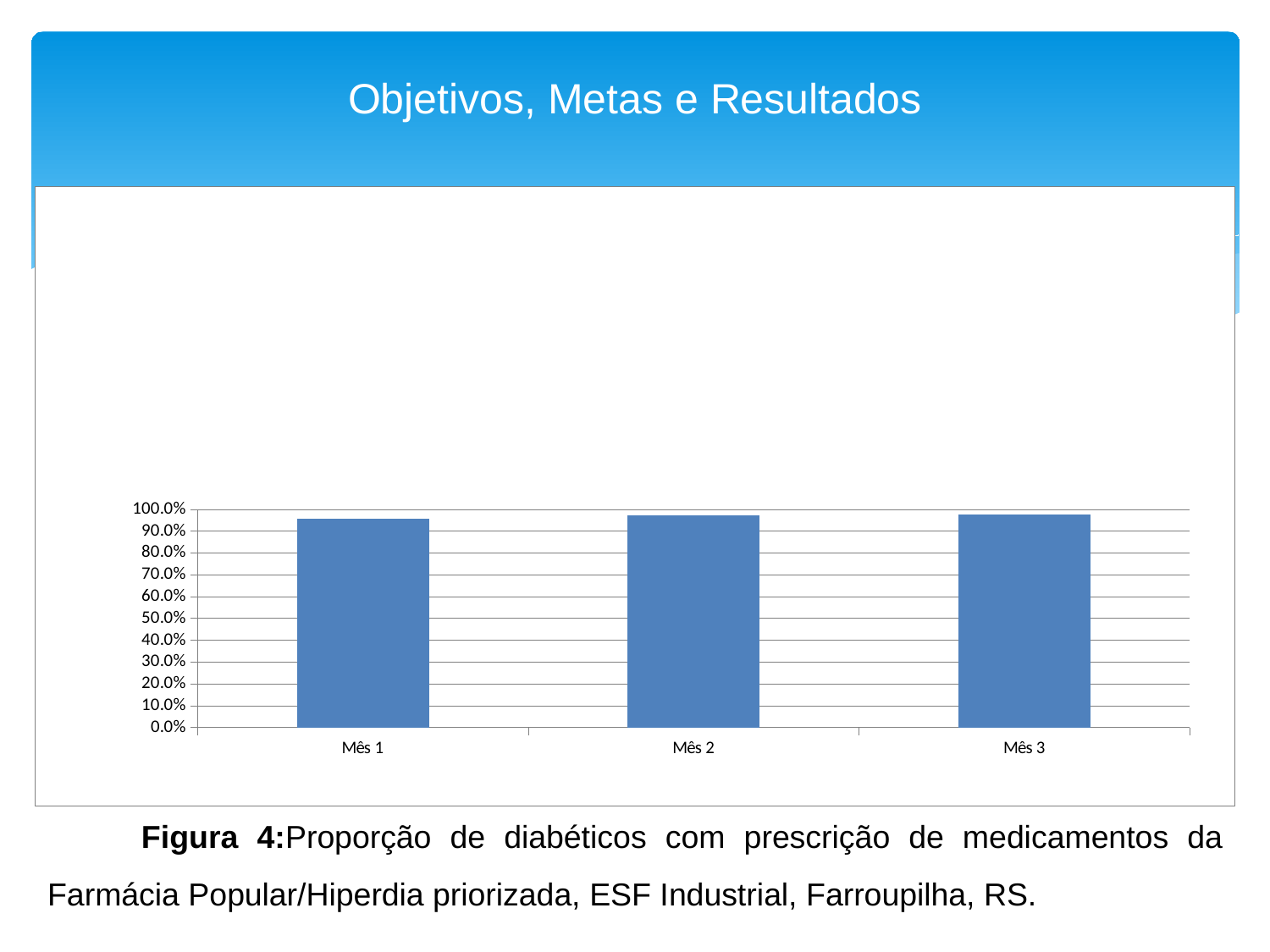
Do the bar values rise or fall from Mês 1 to Mês 3? rise What kind of chart is shown on the slide? bar chart Is the value for Mês 3 greater or less than 90.0%? greater How many categories are plotted on the x axis of the chart? 3 Is the value for Mês 3 greater or less than 80.0%? greater Is the value for Mês 1 greater or less than 90.0%? greater What is the label of the first category on the x axis? Mês 1 What is the highest tick value shown on the y axis of the chart? 100.0%